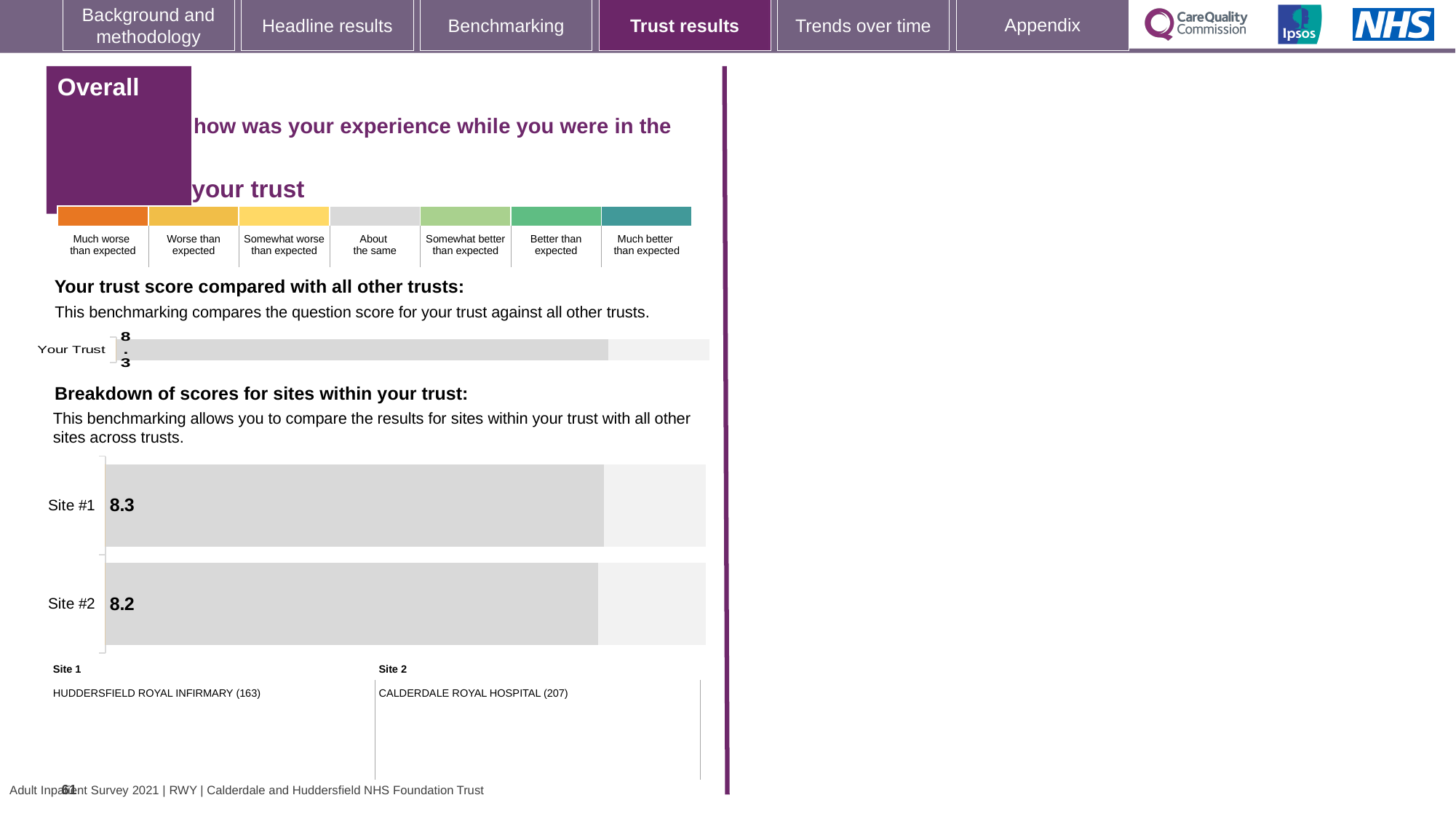
In the 'Breakdown of scores for sites within your trust' chart, what is the score for Site #2? 8.2 In the 'Your trust score compared with all other trusts' chart, what is the score for Your Trust? 8.3 According to the key below the site chart, which hospital is Site 2? CALDERDALE ROYAL HOSPITAL (207) In the 'Breakdown of scores for sites within your trust' chart, which site has the higher score? Site #1 Is the score for Site #1 in the 'Breakdown of scores for sites within your trust' chart greater than or equal to the Your Trust score in the chart above it? Equal In the 'Breakdown of scores for sites within your trust' chart, what is the difference between the scores of Site #1 and Site #2? 0.1 In the 'Your trust score compared with all other trusts' chart, how many bars are plotted? 1 In the 'Breakdown of scores for sites within your trust' chart, how many sites are shown? 2 What type of chart is used in the 'Breakdown of scores for sites within your trust' section? Bar chart In the 'Breakdown of scores for sites within your trust' chart, what is the score for Site #1? 8.3 According to the key below the site chart, which hospital is Site 1? HUDDERSFIELD ROYAL INFIRMARY (163) In the 'Breakdown of scores for sites within your trust' chart, which site has the lower score? Site #2